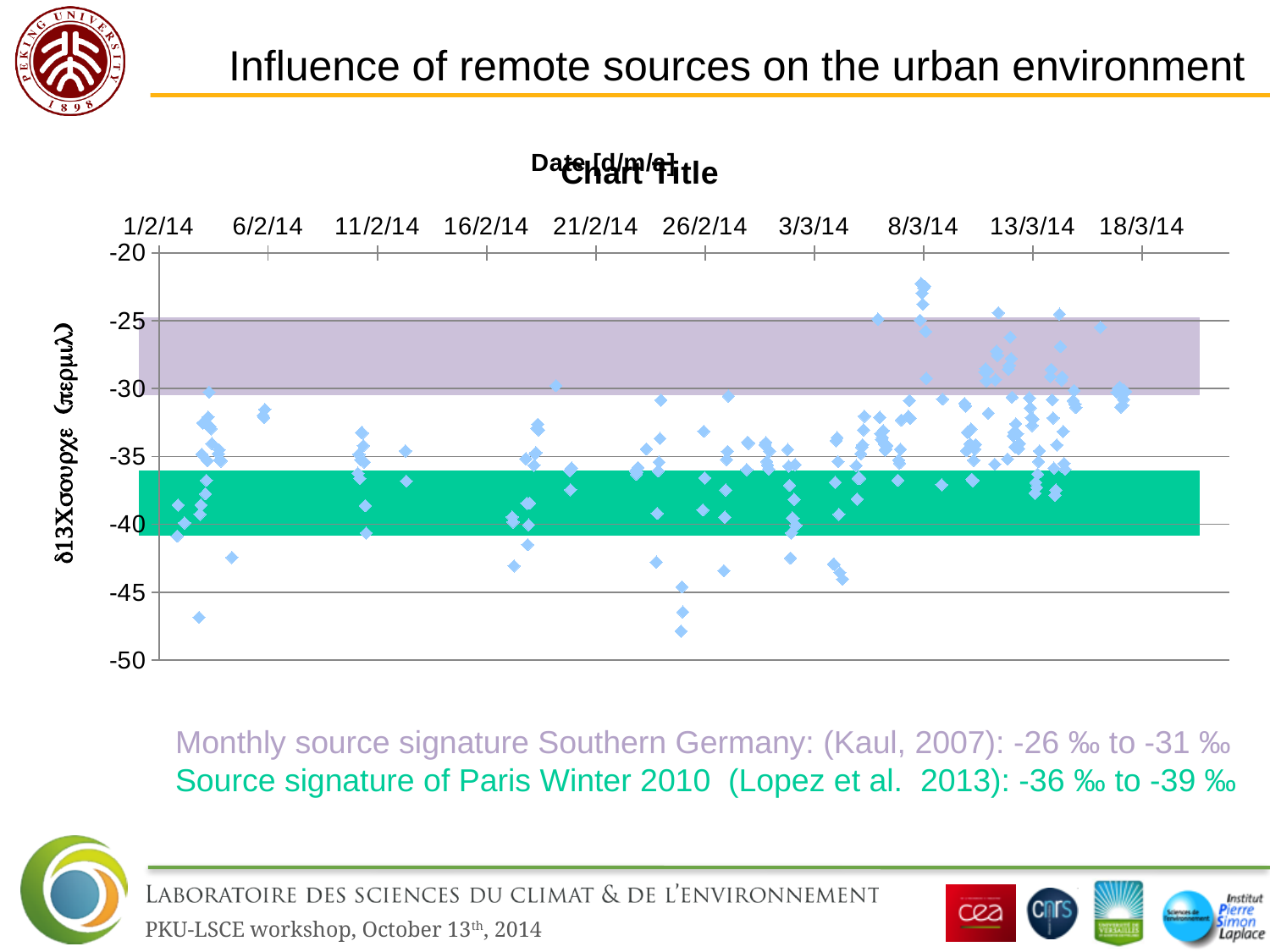
What is the first date label on the x axis of the chart? 1/2/14 Is the highest plotted point near 8/3/14 greater or less than -25? greater What kind of chart is shown on the slide? scatter chart How many date labels are shown along the x axis of the chart? 10 What is the last date label on the x axis of the chart? 18/3/14 Is the lowest plotted point near 26/2/14 greater or less than -45? less Is the lowest plotted point near 1/2/14 greater or less than -45? less Do the plotted values generally rise or fall from February to mid-March along the x axis? rise Around which x-axis date does the chart show its lowest plotted point? 26/2/14 What is the lowest value labelled on the y axis of the chart? -50 Around which x-axis date does the chart show its highest plotted point? 8/3/14 What is the highest value labelled on the y axis of the chart? -20